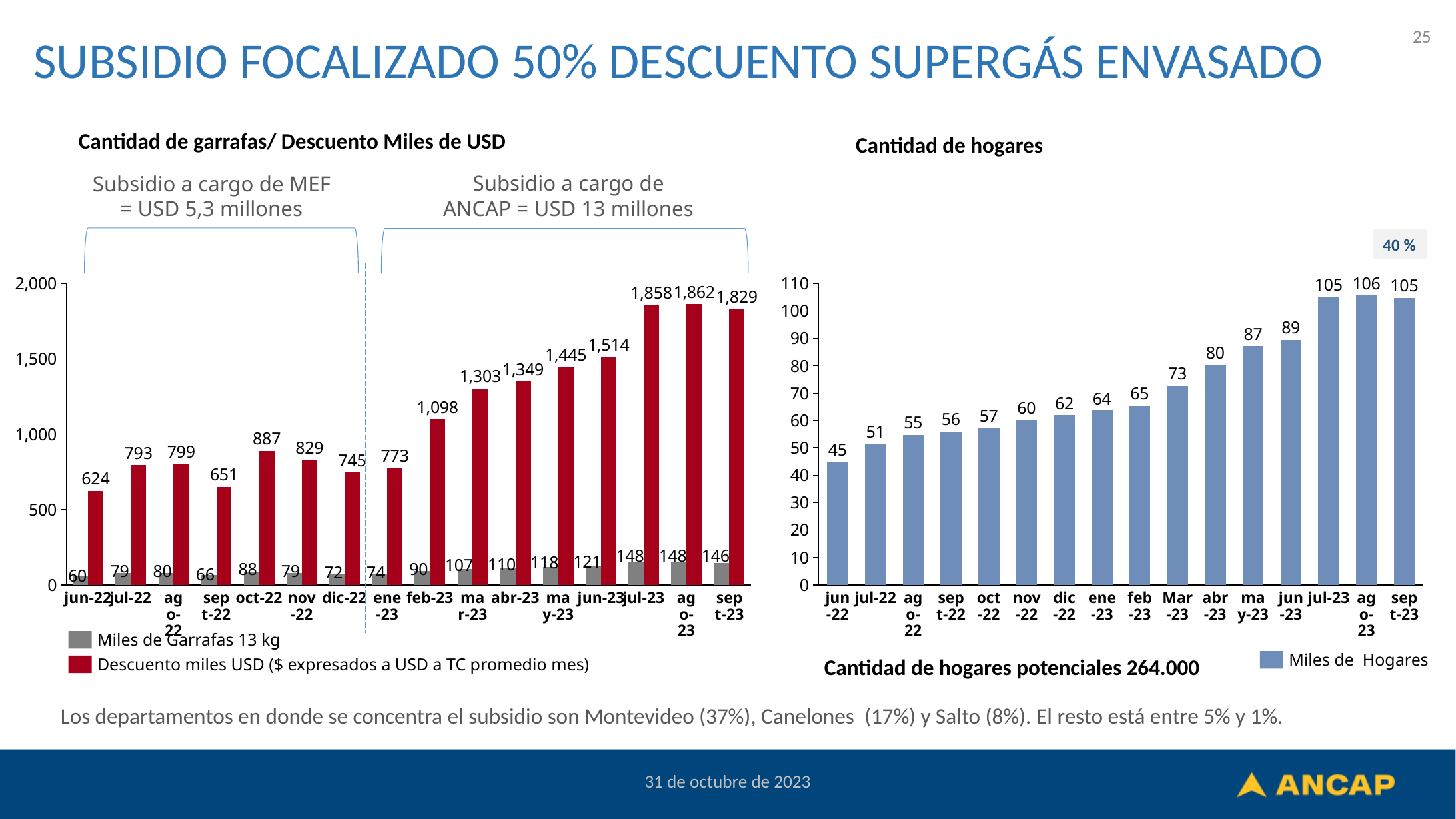
In the 'Cantidad de hogares' chart, is the value for mar-23 larger than the value for dic-22? Yes, mar-23 (73) is larger than dic-22 (62) In the 'Cantidad de garrafas/ Descuento Miles de USD' chart, what is the Miles de Garrafas 13 kg value for jul-23? 148 In the 'Cantidad de garrafas/ Descuento Miles de USD' chart, what is the Descuento miles USD value for oct-22? 887 In the 'Cantidad de hogares' chart, which month has the highest value? ago-23 In the 'Cantidad de garrafas/ Descuento Miles de USD' chart, which month has the highest Descuento miles USD value? ago-23 In the 'Cantidad de garrafas/ Descuento Miles de USD' chart, which month has the lowest Miles de Garrafas 13 kg value? jun-22 In the 'Cantidad de garrafas/ Descuento Miles de USD' chart, what is the difference between the Descuento miles USD values for jul-23 and jun-23? 344 How many months are plotted in the 'Cantidad de hogares' chart? 16 In the 'Cantidad de hogares' chart, what is the value for abr-23? 80 What kind of chart is the 'Cantidad de hogares' chart? Bar chart In the 'Cantidad de hogares' chart, what is the difference between the values for sept-23 and jun-22? 60 How many series does the legend of the 'Cantidad de garrafas/ Descuento Miles de USD' chart list? 2